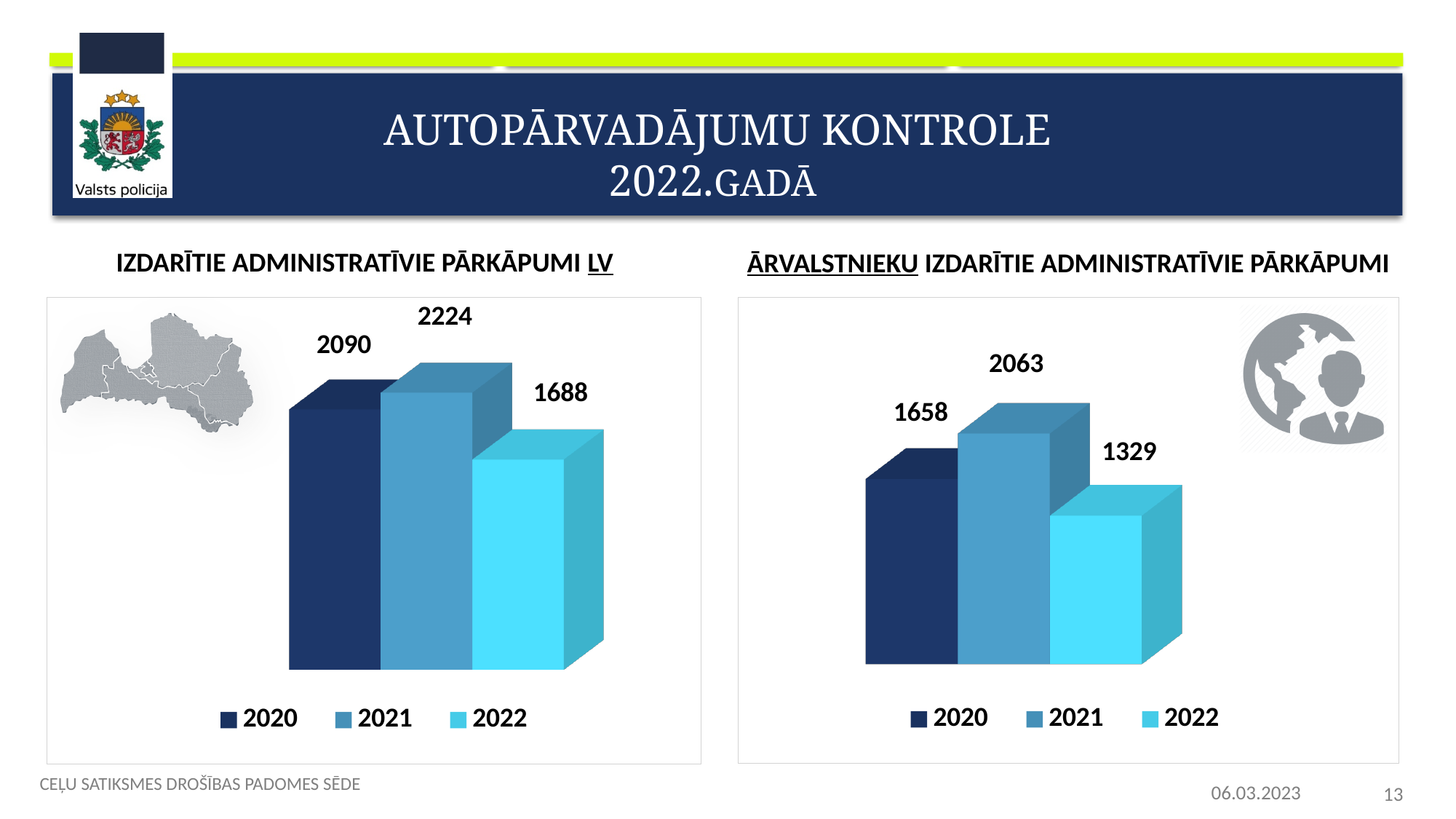
How many series does the legend of the left chart (IZDARĪTIE ADMINISTRATĪVIE PĀRKĀPUMI LV) list? 3 In the left chart (IZDARĪTIE ADMINISTRATĪVIE PĀRKĀPUMI LV), what is the value for 2022? 1688 In the left chart (IZDARĪTIE ADMINISTRATĪVIE PĀRKĀPUMI LV), which year has the highest value? 2021 In the right chart (ĀRVALSTNIEKU IZDARĪTIE ADMINISTRATĪVIE PĀRKĀPUMI), what is the value for 2022? 1329 What kind of chart is the right chart (ĀRVALSTNIEKU IZDARĪTIE ADMINISTRATĪVIE PĀRKĀPUMI)? Bar chart In the left chart (IZDARĪTIE ADMINISTRATĪVIE PĀRKĀPUMI LV), what is the value for 2021? 2224 In the left chart (IZDARĪTIE ADMINISTRATĪVIE PĀRKĀPUMI LV), what is the difference between the 2021 and 2022 values? 536 In the right chart (ĀRVALSTNIEKU IZDARĪTIE ADMINISTRATĪVIE PĀRKĀPUMI), what is the difference between the 2021 and 2020 values? 405 In the left chart (IZDARĪTIE ADMINISTRATĪVIE PĀRKĀPUMI LV), which colour represents 2022 in the legend? Light blue In the right chart (ĀRVALSTNIEKU IZDARĪTIE ADMINISTRATĪVIE PĀRKĀPUMI), which is larger, the value for 2020 or the value for 2022? 2020 In the right chart (ĀRVALSTNIEKU IZDARĪTIE ADMINISTRATĪVIE PĀRKĀPUMI), which year has the lowest value? 2022 In the right chart (ĀRVALSTNIEKU IZDARĪTIE ADMINISTRATĪVIE PĀRKĀPUMI), what is the value for 2020? 1658